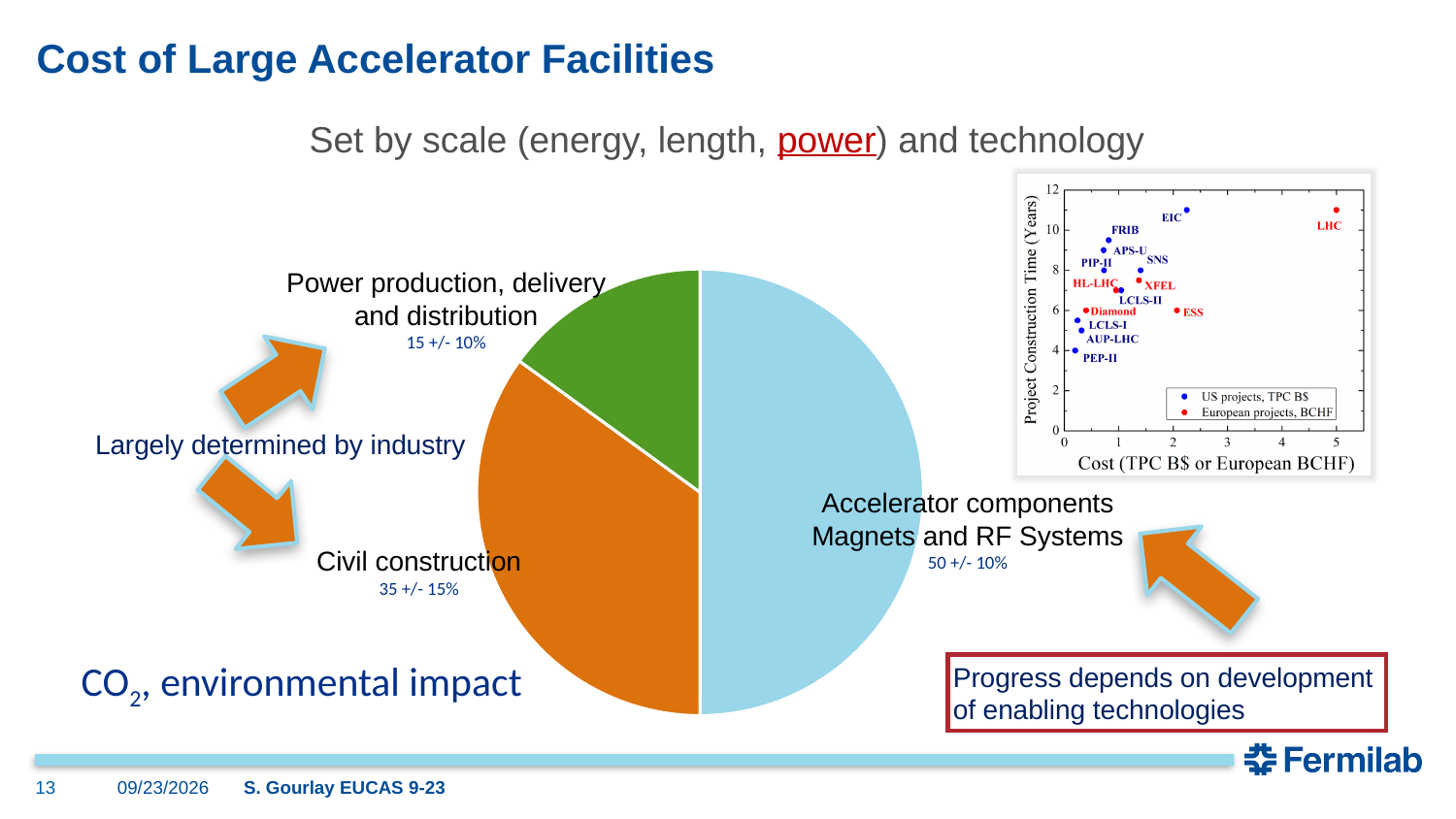
How many slices does the pie chart have? 3 On the pie chart, which category has the smallest slice? Power production, delivery and distribution What kind of chart is the large chart in the centre of the slide? Pie chart On the top-right scatter chart, is the cost for LHC greater or less than 4? greater On the pie chart, what value is shown for Power production, delivery and distribution? 15 +/- 10% On the top-right scatter chart, is the project construction time for PEP-II greater or less than 6 years? less On the pie chart, what value is shown for Accelerator components (Magnets and RF Systems)? 50 +/- 10% On the pie chart, which is larger: Civil construction or Power production, delivery and distribution? Civil construction How many series does the legend of the top-right scatter chart list? 2 What kind of chart is the chart in the top right of the slide (Project Construction Time vs Cost)? Scatter chart On the pie chart, which category has the largest slice? Accelerator components, Magnets and RF Systems On the pie chart, what value is shown for Civil construction? 35 +/- 15%